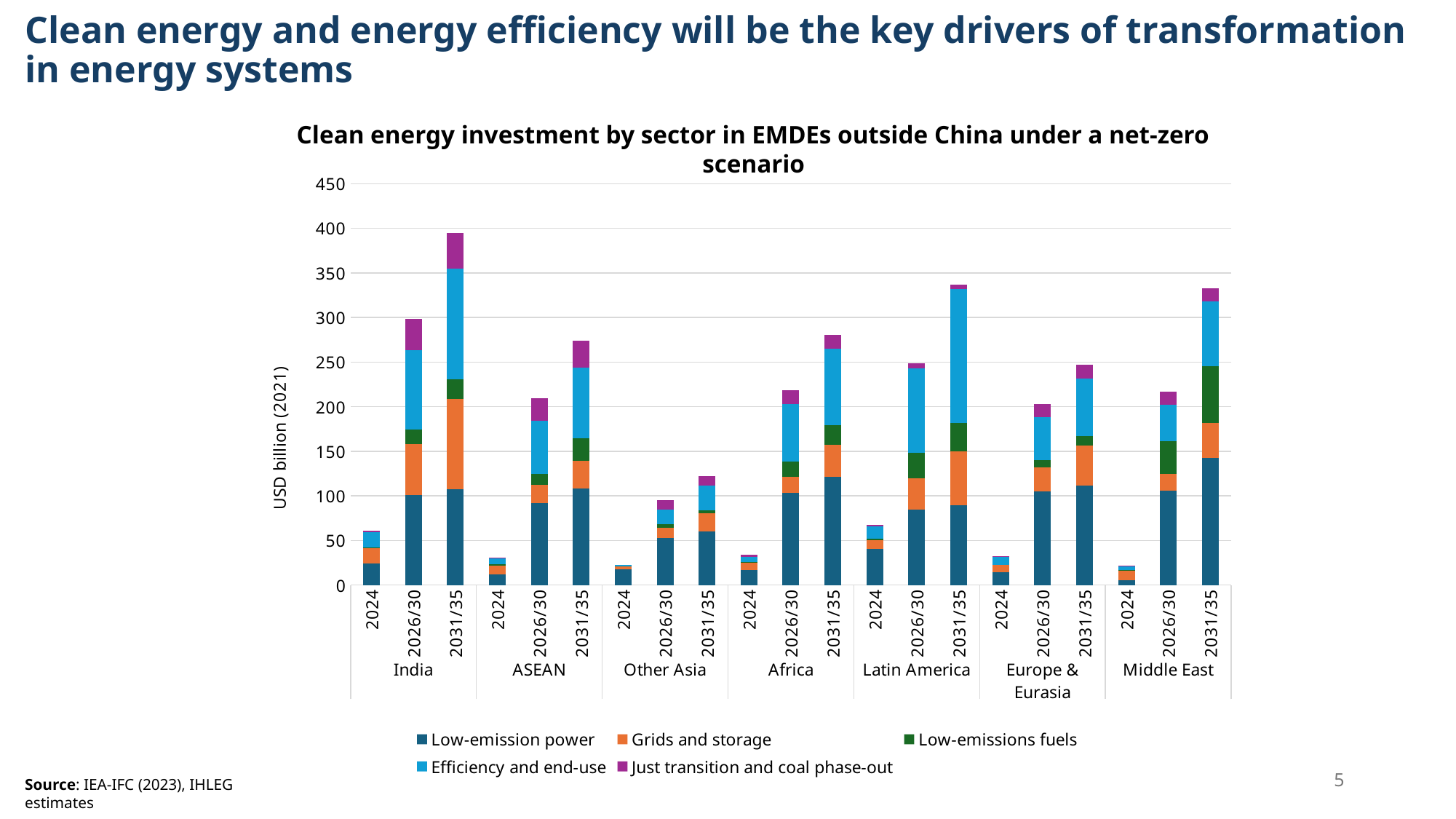
Which region has the tallest bar for 2031/35? India How many stacked bars are plotted in total? 21 Which is larger, the 2031/35 total for Africa or the 2031/35 total for Latin America? Latin America How many regions are shown along the x axis? 7 What kind of chart is shown on the slide? Stacked bar chart How many series does the legend list? 5 Is the total for Latin America in 2031/35 greater or less than 300? greater Is the total for India in 2031/35 greater or less than 350? greater Is the total for ASEAN in 2031/35 greater or less than 250? greater Within each region, do the totals rise or fall from 2024 to 2031/35? rise What is the label on the y axis? USD billion (2021)